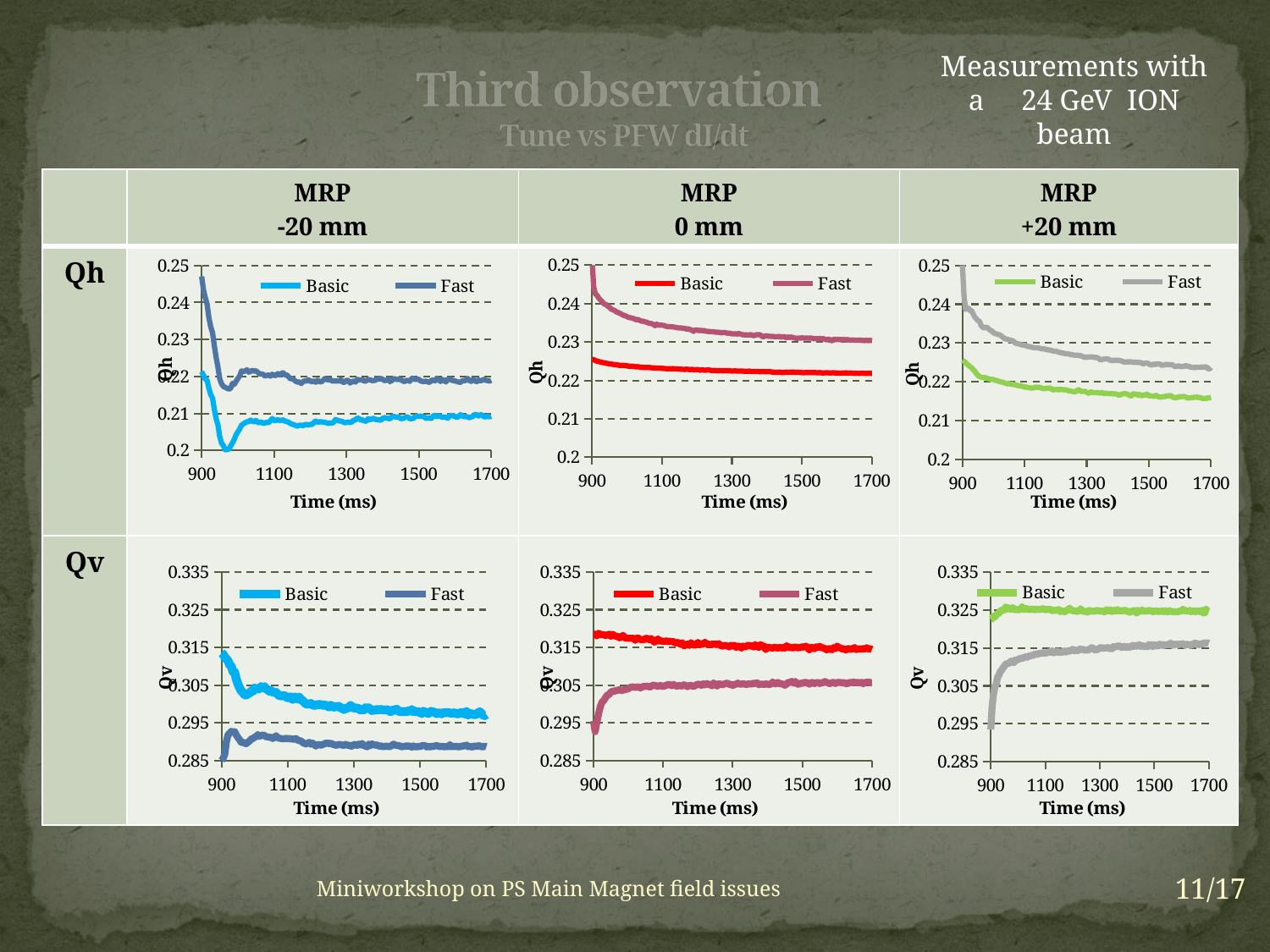
In the Qv MRP +20 mm chart, is the value of the Basic series at 1700 ms greater or less than 0.315? greater What kind of chart is the Qh MRP -20 mm chart? line chart In the Qv MRP 0 mm chart, is the value of the Fast series at 1700 ms greater or less than 0.315? less In the Qh MRP 0 mm chart, which series is higher at 1700 ms, Basic or Fast? Fast In the Qv MRP +20 mm chart, does the Fast series rise or fall as time increases from 900 to 1700 ms? rise What are the two series named in the legend of the Qv MRP +20 mm chart? Basic and Fast In the Qh MRP 0 mm chart, does the Fast series rise or fall as time increases from 900 to 1700 ms? fall What is the x-axis label on the Qh MRP +20 mm chart? Time (ms) In the Qv MRP 0 mm chart, does the Basic series rise or fall as time increases from 900 to 1700 ms? fall How many series does the legend of the Qh MRP 0 mm chart list? 2 In the Qh MRP 0 mm chart, is the value of the Basic series at 1700 ms greater or less than 0.23? less In the Qv MRP -20 mm chart, which series is higher at 1700 ms, Basic or Fast? Basic